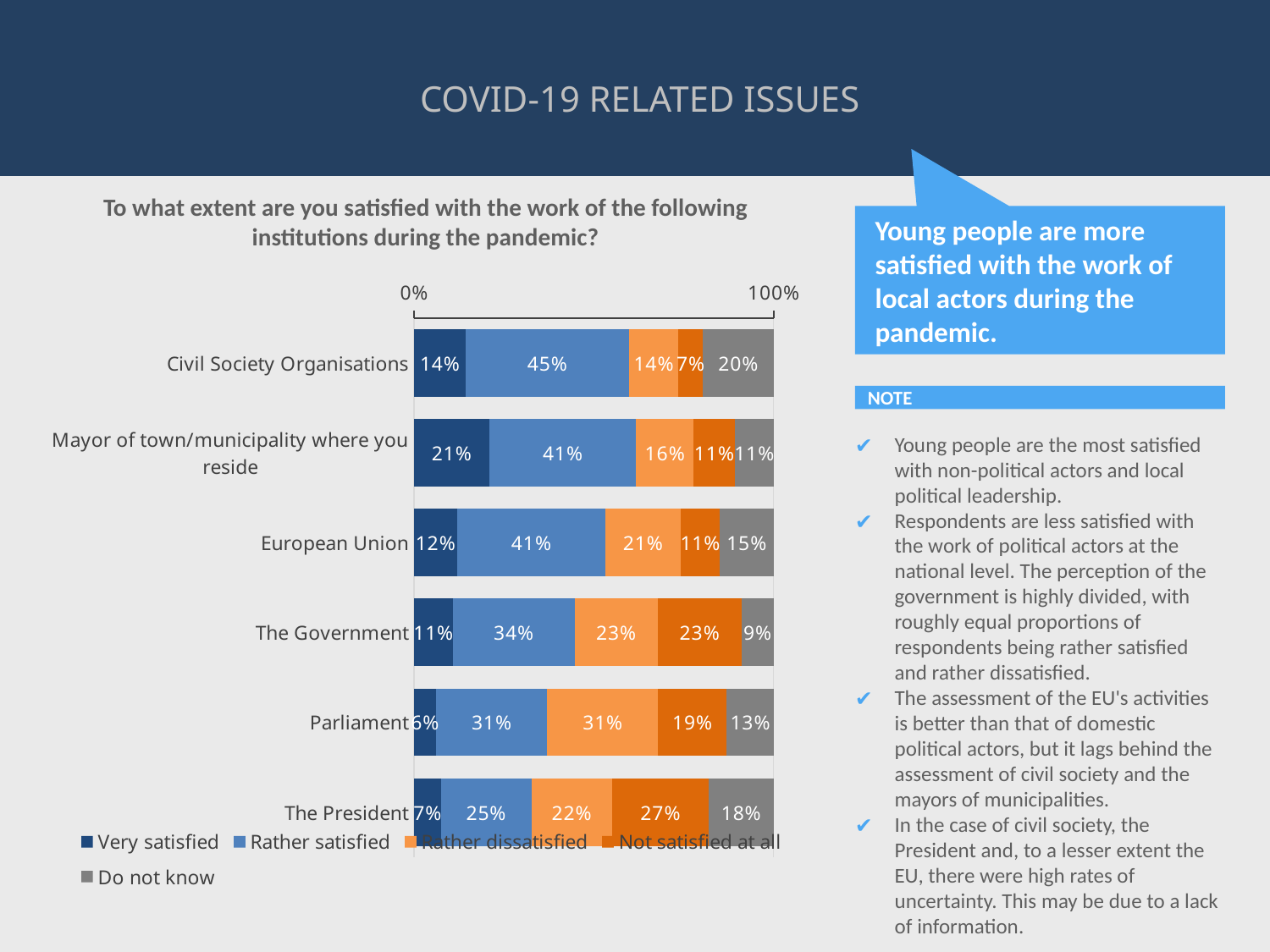
How many percentage points higher is the "Not satisfied at all" value for The President than for Civil Society Organisations? 20 percentage points What is the combined share of "Very satisfied" and "Rather satisfied" for Civil Society Organisations? 59% How many institutions are shown in the chart? 6 What percentage of respondents are "Very satisfied" with the Mayor of town/municipality where you reside? 21% Which has a larger "Rather dissatisfied" share, The Government or the European Union? The Government What is the "Rather satisfied" value for Civil Society Organisations? 45% Which institution has the lowest "Very satisfied" share? Parliament What type of chart is shown on the slide? Stacked bar chart How many response categories does the legend list? 5 Which institution has the highest "Very satisfied" share? Mayor of town/municipality where you reside Which institution has the highest "Not satisfied at all" share? The President What is the "Do not know" value for The President? 18%